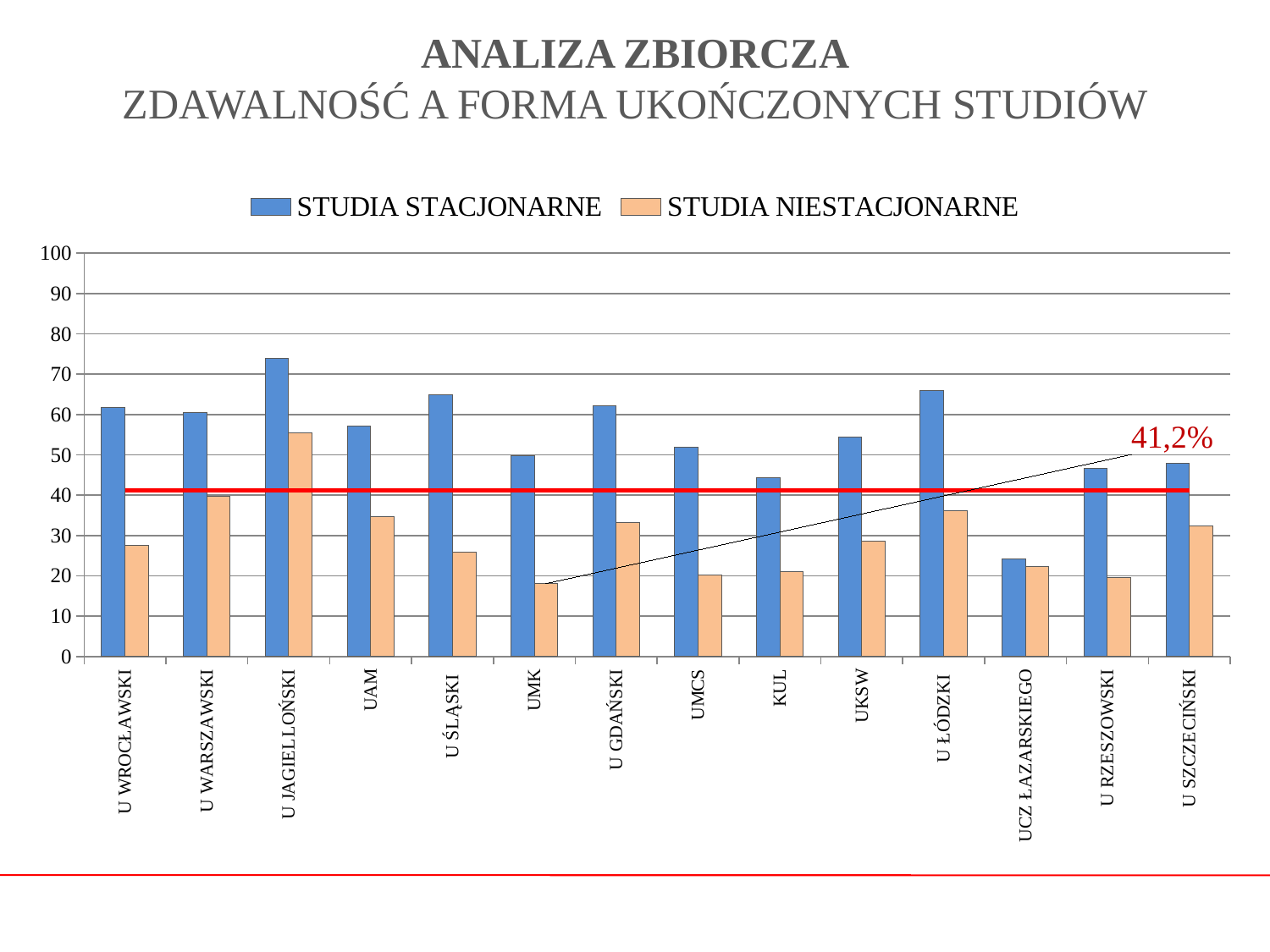
Which is larger, the STUDIA NIESTACJONARNE value for U WARSZAWSKI or for UMCS? U WARSZAWSKI What value is labelled on the red horizontal line across the chart? 41,2% How many universities are shown on the x axis? 14 Which is larger, the STUDIA STACJONARNE value for U ŁÓDZKI or for UKSW? U ŁÓDZKI Which university has the highest value for STUDIA NIESTACJONARNE? U JAGIELLOŃSKI Is the STUDIA STACJONARNE value for U JAGIELLOŃSKI greater or less than 70? greater Is the STUDIA STACJONARNE value for UCZ ŁAZARSKIEGO greater or less than 30? less How many series does the legend list? 2 Which university has the highest value for STUDIA STACJONARNE? U JAGIELLOŃSKI Which university has the lowest value for STUDIA STACJONARNE? UCZ ŁAZARSKIEGO What kind of chart is shown on the slide? bar chart Is the STUDIA NIESTACJONARNE value for U JAGIELLOŃSKI greater or less than 50? greater